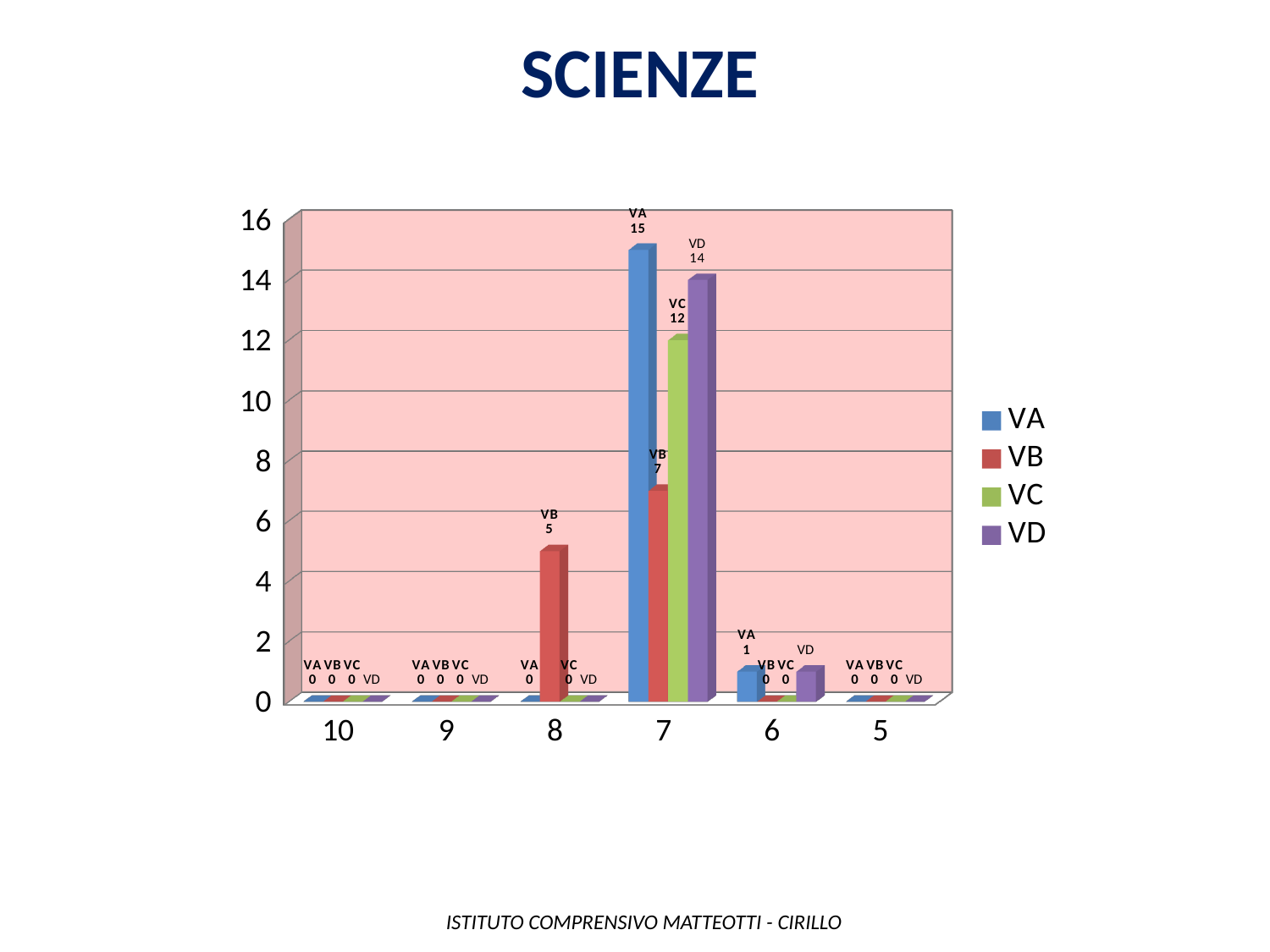
What is the value for VB at category 8? 5 How many series does the legend list? 4 What is the title of the chart? SCIENZE Is the value for VD at category 6 greater or less than 4? less What is the value for VC at category 7? 12 What kind of chart is shown on the slide? bar chart How many categories are shown on the x axis? 6 Which series has the highest value at category 7? VA What is the value for VD at category 7? 14 What is the difference between VA and VB at category 7? 8 Which is larger at category 7, VC or VD? VD What is the value for VA at category 7? 15